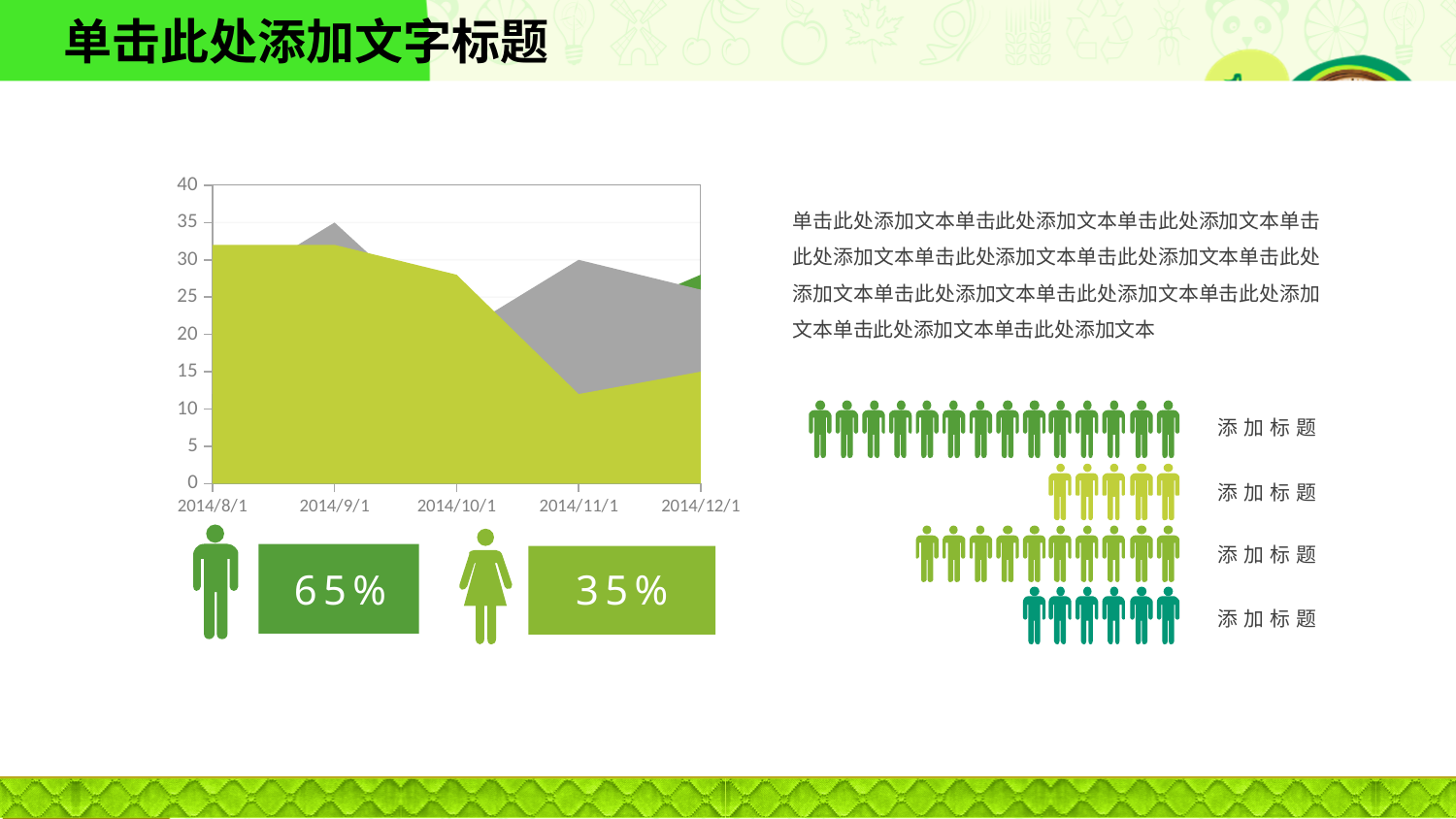
How many dates are shown along the x axis of the area chart? 5 Is the value of the yellow-green area at 2014/12/1 greater or less than 20? less What kind of chart is shown on the slide? area chart At 2014/11/1, which is larger: the gray area or the yellow-green area? the gray area Is the value of the yellow-green area at 2014/8/1 greater or less than 30? greater What is the first date shown on the x axis of the area chart? 2014/8/1 At which date does the yellow-green area reach its lowest value? 2014/11/1 What is the highest value shown on the y axis of the area chart? 40 Is the value of the gray area at 2014/9/1 greater or less than 30? greater Does the yellow-green area rise or fall from 2014/8/1 to 2014/11/1? fall